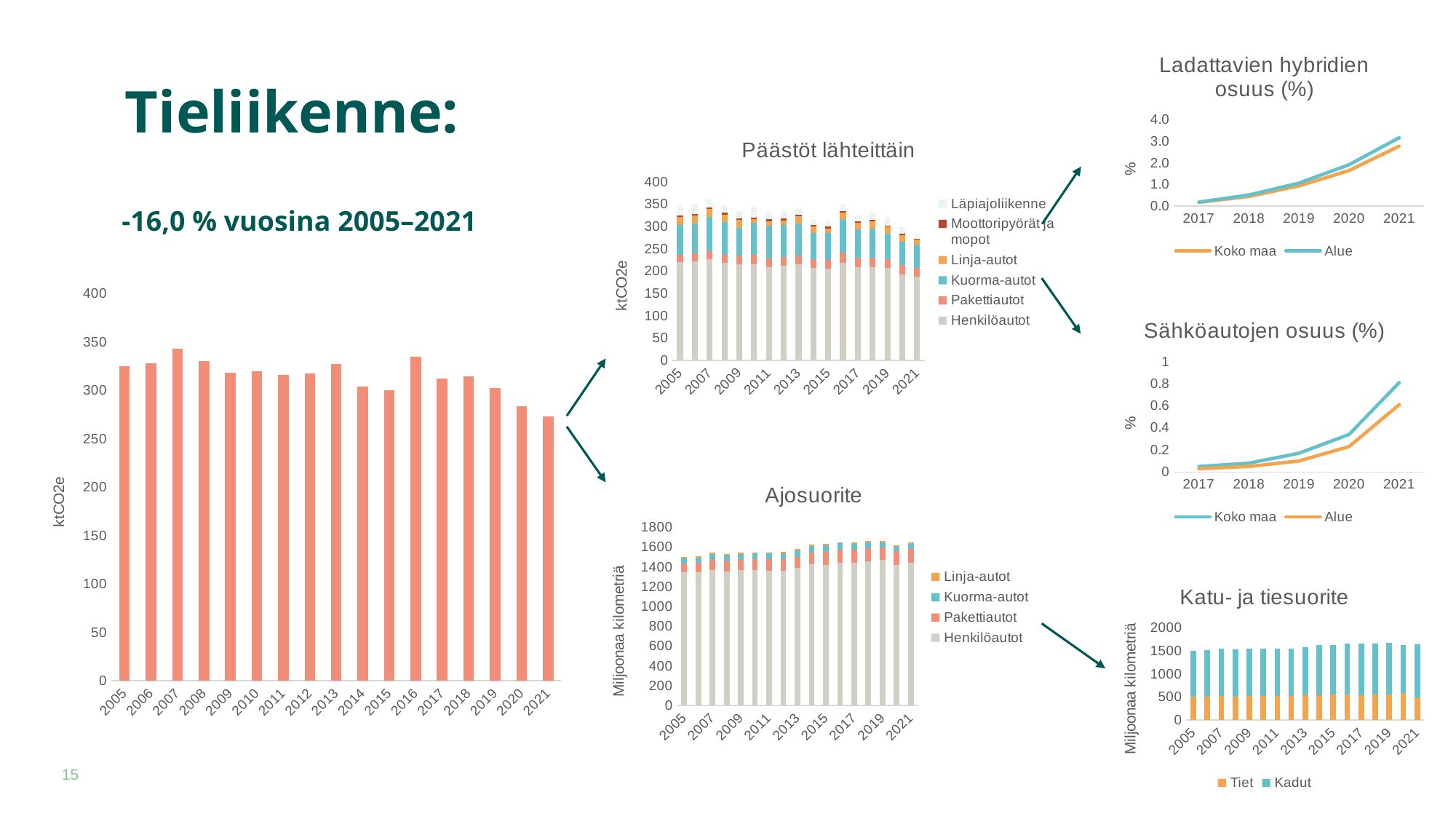
In the 'Ladattavien hybridien osuus (%)' chart, is the value for Alue in 2021 greater or less than 3.0? greater In the large bar chart on the left of the slide, which year has the lowest value? 2021 How many series does the legend of the 'Päästöt lähteittäin' chart list? 6 In the 'Ladattavien hybridien osuus (%)' chart, do the values rise or fall from 2017 to 2021? rise Which two series does the legend of the 'Katu- ja tiesuorite' chart list? Tiet and Kadut How many series does the legend of the 'Ajosuorite' chart list? 4 What kind of chart is 'Ladattavien hybridien osuus (%)'? line chart In the large bar chart on the left of the slide, is the value for 2021 greater or less than 300? less In the 'Sähköautojen osuus (%)' chart, which series is higher in 2021, Koko maa or Alue? Koko maa In the large bar chart on the left of the slide, how many years are plotted? 17 What kind of chart is the large chart on the left of the slide? bar chart In the large bar chart on the left of the slide, is the value for 2007 greater or less than 300? greater